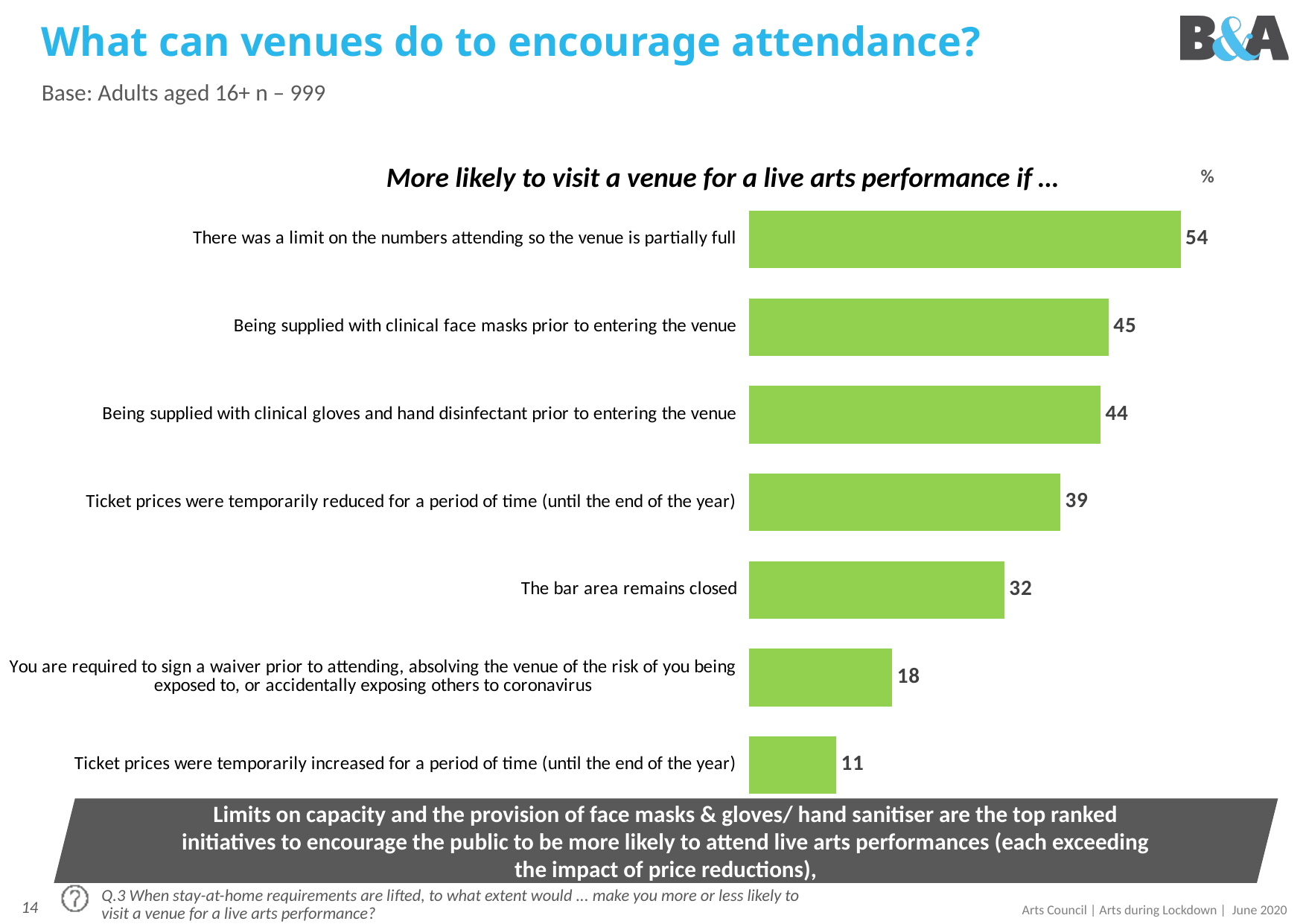
What percentage of adults said they would be more likely to visit a venue if there was a limit on the numbers attending so the venue is partially full? 54 What value is shown for being required to sign a waiver prior to attending? 18 What is the difference between the values for being supplied with clinical face masks and being supplied with clinical gloves and hand disinfectant? 1 How many initiatives (bars) are shown on the chart? 7 What colour are the bars in the chart? Green Which initiative has the lowest value on the chart? Ticket prices were temporarily increased for a period of time (until the end of the year) What is the title of the chart? More likely to visit a venue for a live arts performance if ... What type of chart is shown on the slide? Bar chart What value is shown for 'The bar area remains closed'? 32 Which initiative has the highest value on the chart? There was a limit on the numbers attending so the venue is partially full What is the difference between the values for ticket prices being temporarily reduced and ticket prices being temporarily increased? 28 Which has a larger value: 'The bar area remains closed' or 'Ticket prices were temporarily reduced for a period of time (until the end of the year)'? Ticket prices were temporarily reduced for a period of time (until the end of the year)